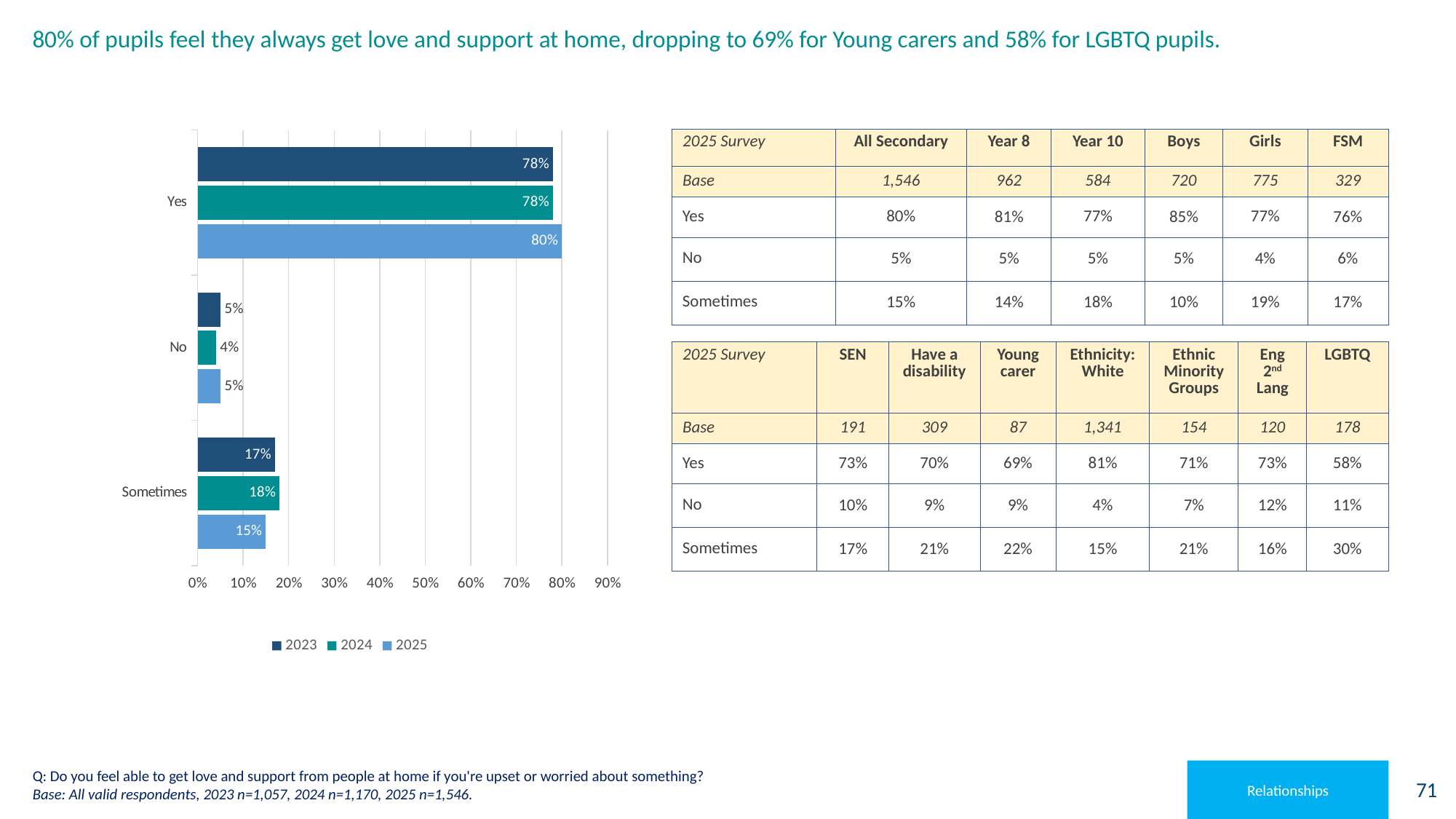
What is the value for Sometimes in 2024? 18% What is the difference between the Yes values for 2025 and 2023? 2% What kind of chart is shown on the slide? bar chart How many series does the legend list? 3 Which category has the lowest value in 2024? No What is the value for No in 2023? 5% Which series is shown in the darkest blue colour? 2023 Which is larger, the Sometimes value for 2023 or for 2025? 2023 How many categories are shown on the chart? 3 Which category has the highest value in 2025? Yes What is the value for Yes in 2025? 80% Is the value for Yes in 2024 greater or less than 70%? greater